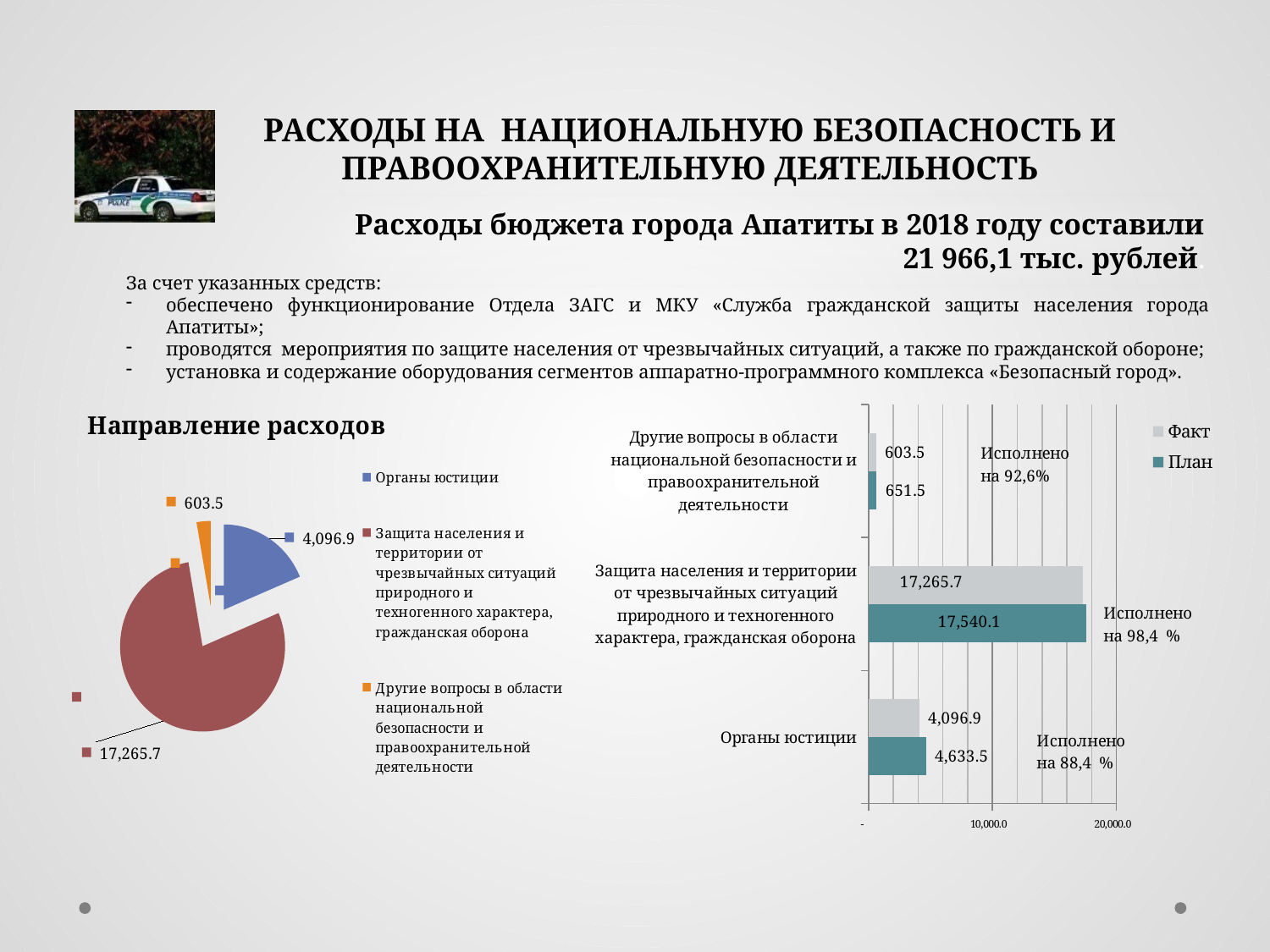
On the bar chart on the right, is the Факт value for "Органы юстиции" greater or less than 10,000.0? less On the bar chart on the right, what is the difference between the План and Факт values for "Органы юстиции"? 536.6 On the pie chart titled "Направление расходов", which category has the largest slice? Защита населения и территории от чрезвычайных ситуаций природного и техногенного характера, гражданская оборона On the pie chart titled "Направление расходов", which category has the smallest slice? Другие вопросы в области национальной безопасности и правоохранительной деятельности On the bar chart on the right, what is the План value for "Другие вопросы в области национальной безопасности и правоохранительной деятельности"? 651.5 On the bar chart on the right, what is the План value for "Органы юстиции"? 4,633.5 What kind of chart is the chart on the right side of the slide? Bar chart On the bar chart on the right, how many series does the legend list? 2 On the pie chart titled "Направление расходов", how many categories does the legend list? 3 On the pie chart titled "Направление расходов", what is the value for "Органы юстиции"? 4,096.9 On the bar chart on the right, what is the Факт value for "Защита населения и территории от чрезвычайных ситуаций природного и техногенного характера, гражданская оборона"? 17,265.7 On the bar chart on the right, which is larger for "Защита населения и территории от чрезвычайных ситуаций природного и техногенного характера, гражданская оборона": Факт or План? План